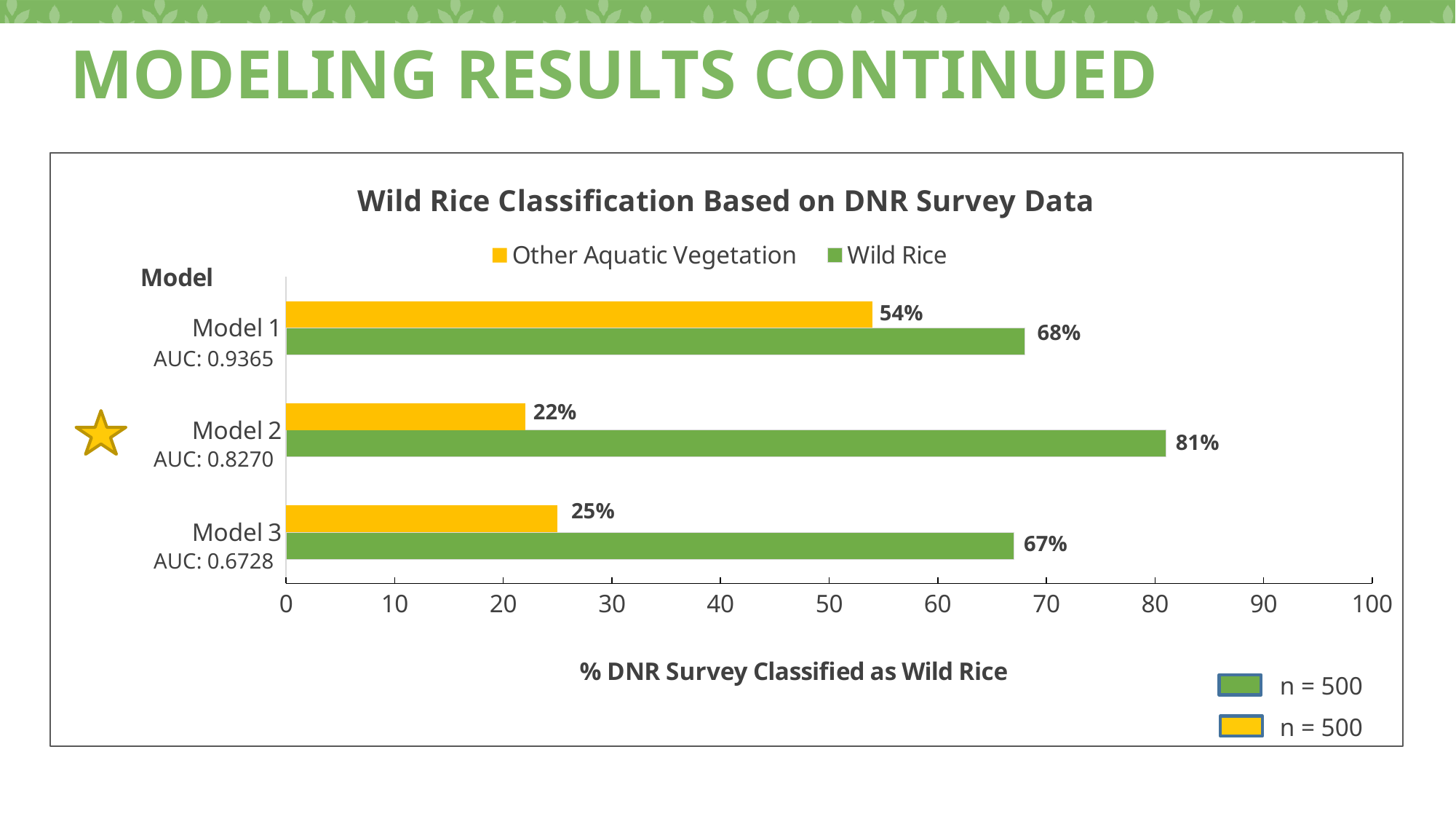
What is the Other Aquatic Vegetation value for Model 3? 25% What is the difference between the Wild Rice and Other Aquatic Vegetation values for Model 2? 59% Which model has the highest Wild Rice value? Model 2 Is the Wild Rice value for Model 3 greater or less than 60? greater What is the title of the chart? Wild Rice Classification Based on DNR Survey Data How many series does the legend list? 2 What kind of chart is shown on the slide? Bar chart Which is larger for Model 1: the Wild Rice value or the Other Aquatic Vegetation value? Wild Rice What is the Wild Rice value for Model 2? 81% What is the Other Aquatic Vegetation value for Model 1? 54% Which model has the lowest Other Aquatic Vegetation value? Model 2 How many models are shown on the chart? 3